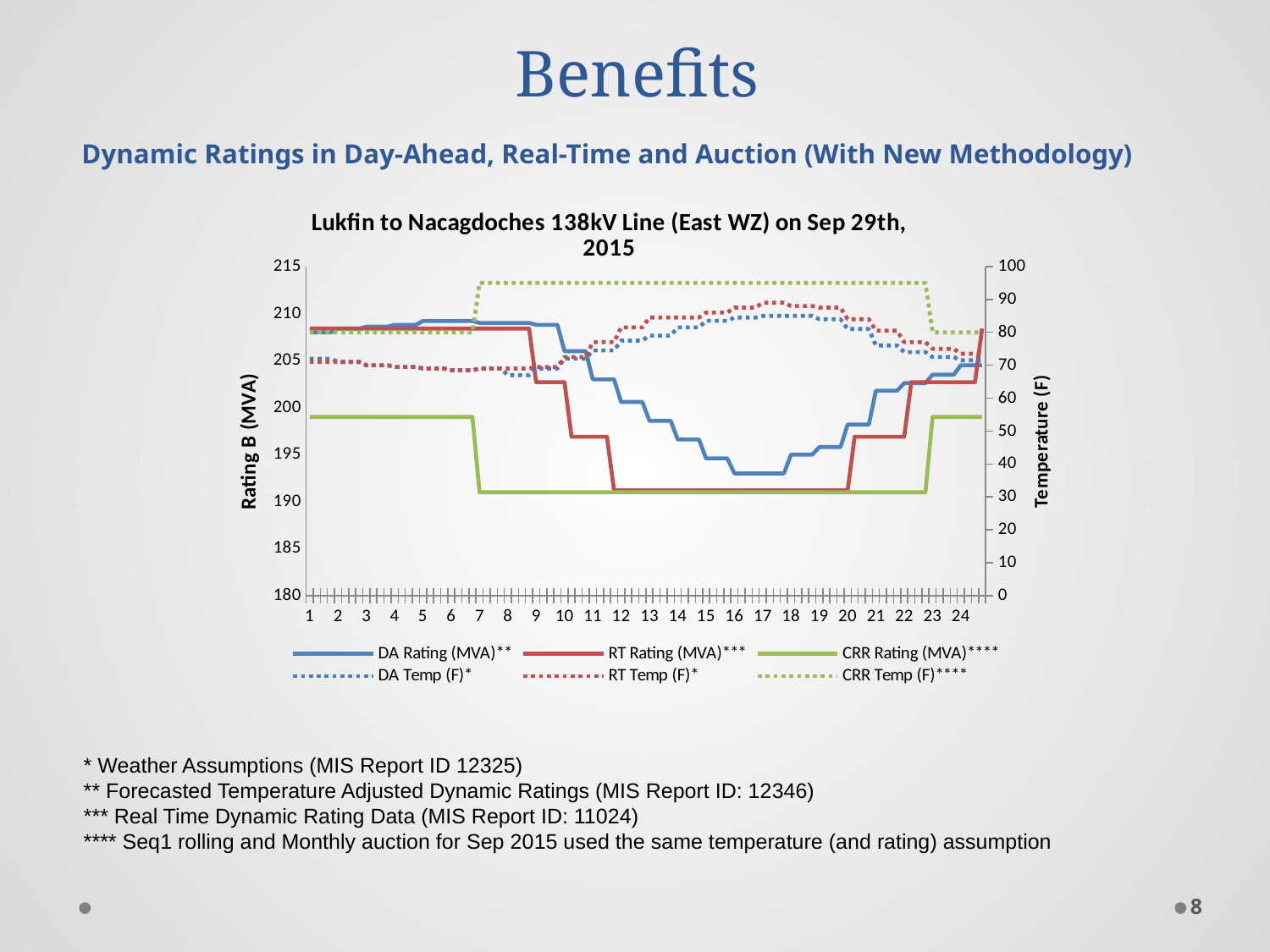
Is the DA Rating (MVA) value at hour 3 greater or less than 205? greater How many hours are labelled along the x axis of the chart? 24 At hour 12, which is larger: the DA Rating (MVA) or the RT Rating (MVA)? DA Rating (MVA) What is the title of the chart? Lukfin to Nacagdoches 138kV Line (East WZ) on Sep 29th, 2015 Is the CRR Rating (MVA) value at hour 16 greater or less than 195? less Does the DA Rating (MVA) line rise or fall between hour 10 and hour 16? fall At hour 12, which temperature series has the highest value? CRR Temp (F) Is the CRR Temp (F) value at hour 12 greater or less than 90? greater What is the label of the right-hand vertical axis of the chart? Temperature (F) How many series does the chart's legend list? 6 What kind of chart is shown on the slide? line chart